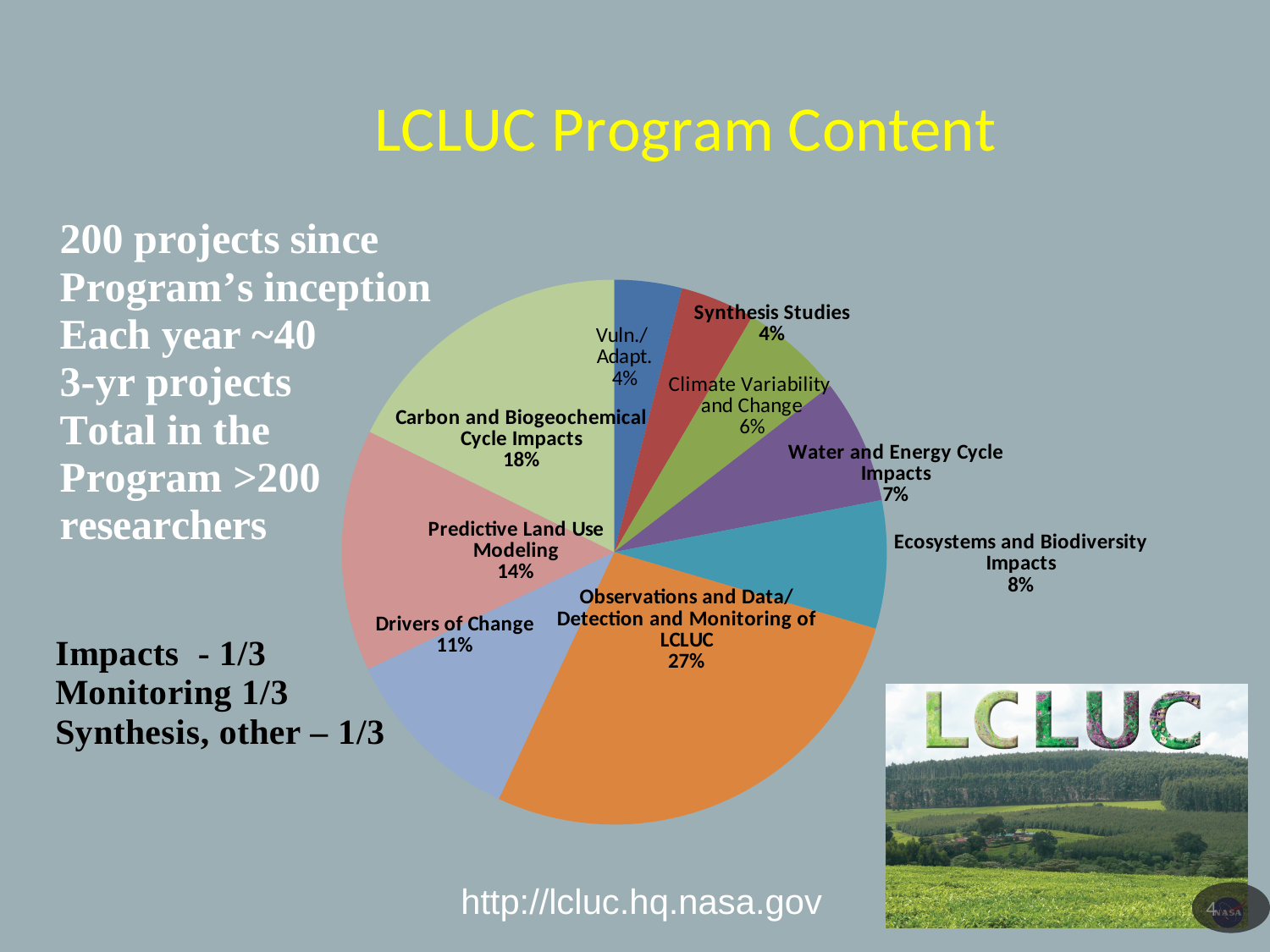
Which is larger, Climate Variability and Change or Water and Energy Cycle Impacts? Water and Energy Cycle Impacts What kind of chart is shown on the slide? pie chart What percentage is shown for Carbon and Biogeochemical Cycle Impacts? 18% What percentage is shown for Drivers of Change? 11% What is the difference in percentage points between Carbon and Biogeochemical Cycle Impacts and Predictive Land Use Modeling? 4 What percentage is shown for Ecosystems and Biodiversity Impacts? 8% What percentage is shown for Predictive Land Use Modeling? 14% What percentage is shown for Water and Energy Cycle Impacts? 7% Which category has the largest slice of the pie? Observations and Data/Detection and Monitoring of LCLUC What share of the pie is Observations and Data/Detection and Monitoring of LCLUC? 27% What is the title of the slide containing the pie chart? LCLUC Program Content How many slices does the pie chart have? 9